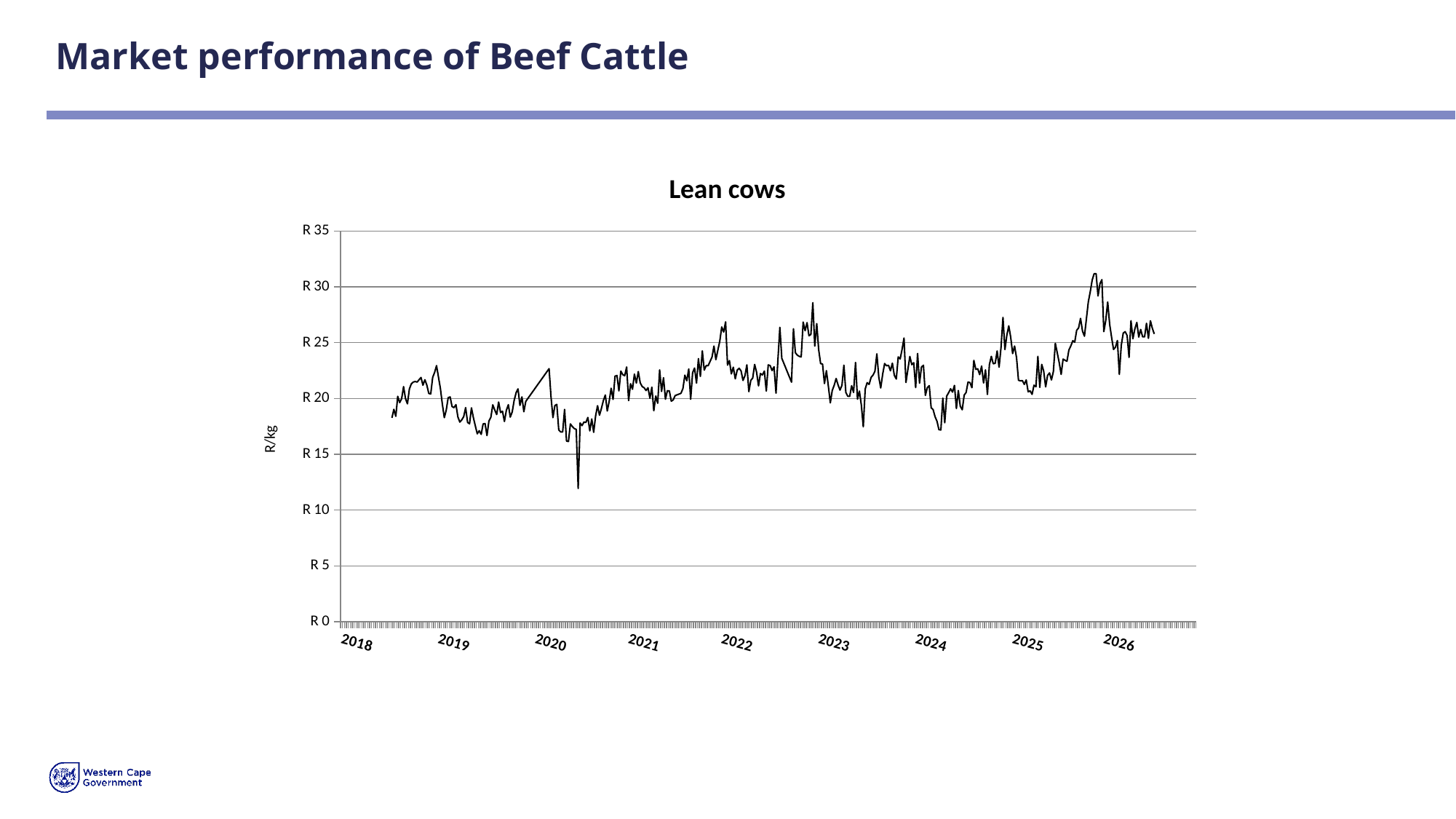
Is the peak of the line in late 2022 greater or less than R 25? greater Is the lowest point of the line, in 2020, greater or less than R 15? less What is the highest value shown on the vertical axis of the chart? R 35 What is the title of the chart? Lean cows Is the highest point of the line, in 2025, greater or less than R 30? greater In which year does the line reach its lowest value? 2020 In which year does the line reach its highest value? 2025 How many year labels are shown along the x axis of the chart? 9 What is the label on the vertical axis of the chart? R/kg Overall, do the values rise or fall from 2018 to 2026? rise What kind of chart is shown on the slide? line chart